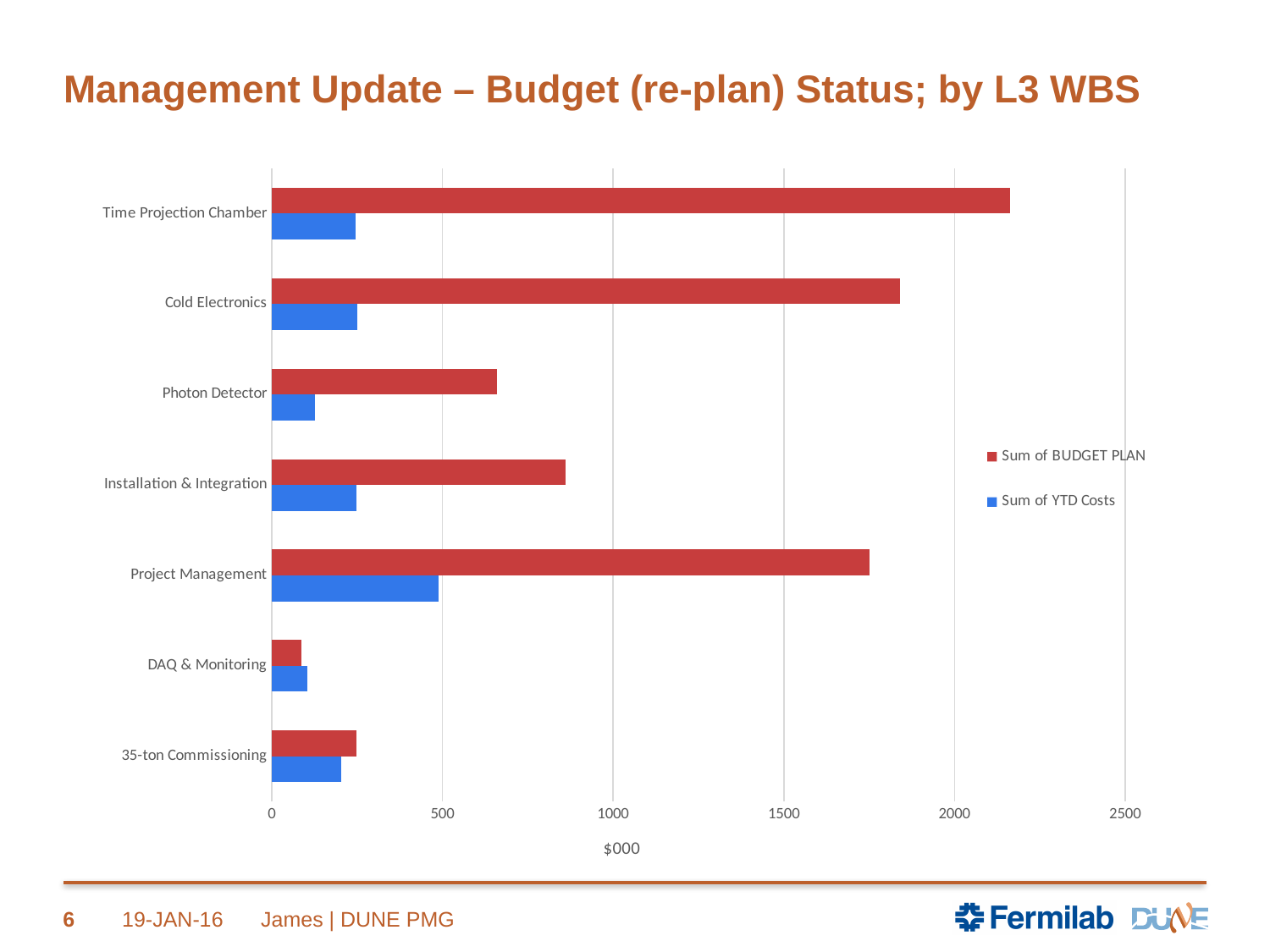
Is the Sum of BUDGET PLAN for Time Projection Chamber greater or less than 2000? greater Which category has the highest Sum of BUDGET PLAN? Time Projection Chamber What kind of chart is shown on the slide? bar chart How many series does the legend list? 2 Which category has the lowest Sum of BUDGET PLAN? DAQ & Monitoring Which is larger for Cold Electronics: the Sum of BUDGET PLAN or the Sum of YTD Costs? Sum of BUDGET PLAN Which category has the highest Sum of YTD Costs? Project Management Is the Sum of BUDGET PLAN for Photon Detector greater or less than 1000? less What unit label is shown on the horizontal axis of the chart? $000 Which category has a larger Sum of BUDGET PLAN: Installation & Integration or Photon Detector? Installation & Integration How many L3 WBS categories are plotted on the chart? 7